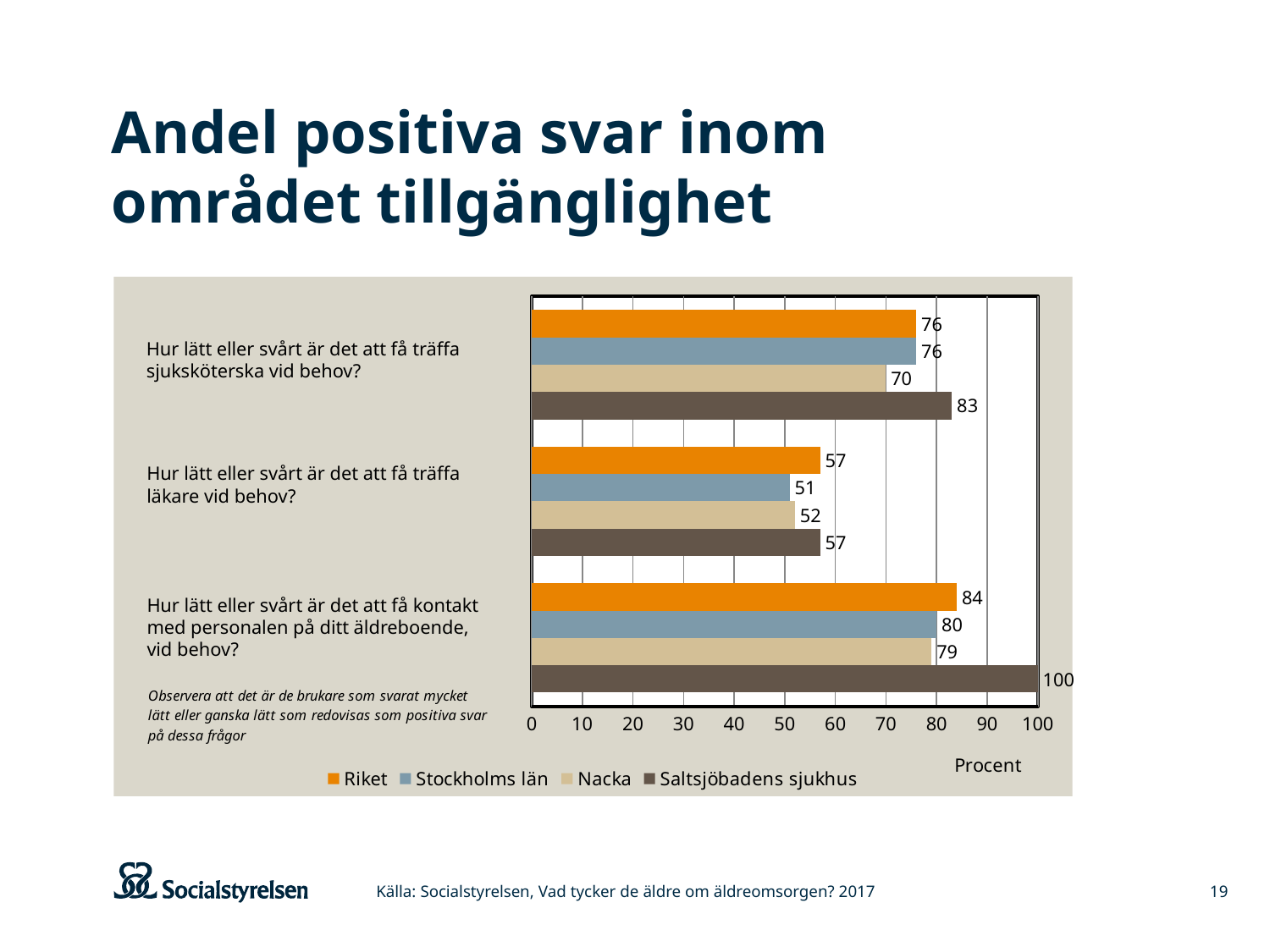
How many series does the legend list? 4 Which is larger on the question about meeting a nurse when needed: Riket or Nacka? Riket What is the difference between Riket and Stockholms län on the question about meeting a doctor when needed? 6 What is the value for Nacka on the question about meeting a nurse when needed ("Hur lätt eller svårt är det att få träffa sjuksköterska vid behov?")? 70 How many question categories are plotted on the chart? 3 Which series has the highest value on the question about meeting a nurse when needed? Saltsjöbadens sjukhus Which series has the lowest value on the question about meeting a doctor when needed? Stockholms län What kind of chart is shown on the slide? Bar chart What is the value for Saltsjöbadens sjukhus on the question about getting in contact with staff at the care home ("Hur lätt eller svårt är det att få kontakt med personalen på ditt äldreboende, vid behov?")? 100 What is the difference between Saltsjöbadens sjukhus and Nacka on the question about getting in contact with staff at the care home? 21 What unit is shown on the x axis of the chart? Procent What is the value for Stockholms län on the question about meeting a doctor when needed ("Hur lätt eller svårt är det att få träffa läkare vid behov?")? 51